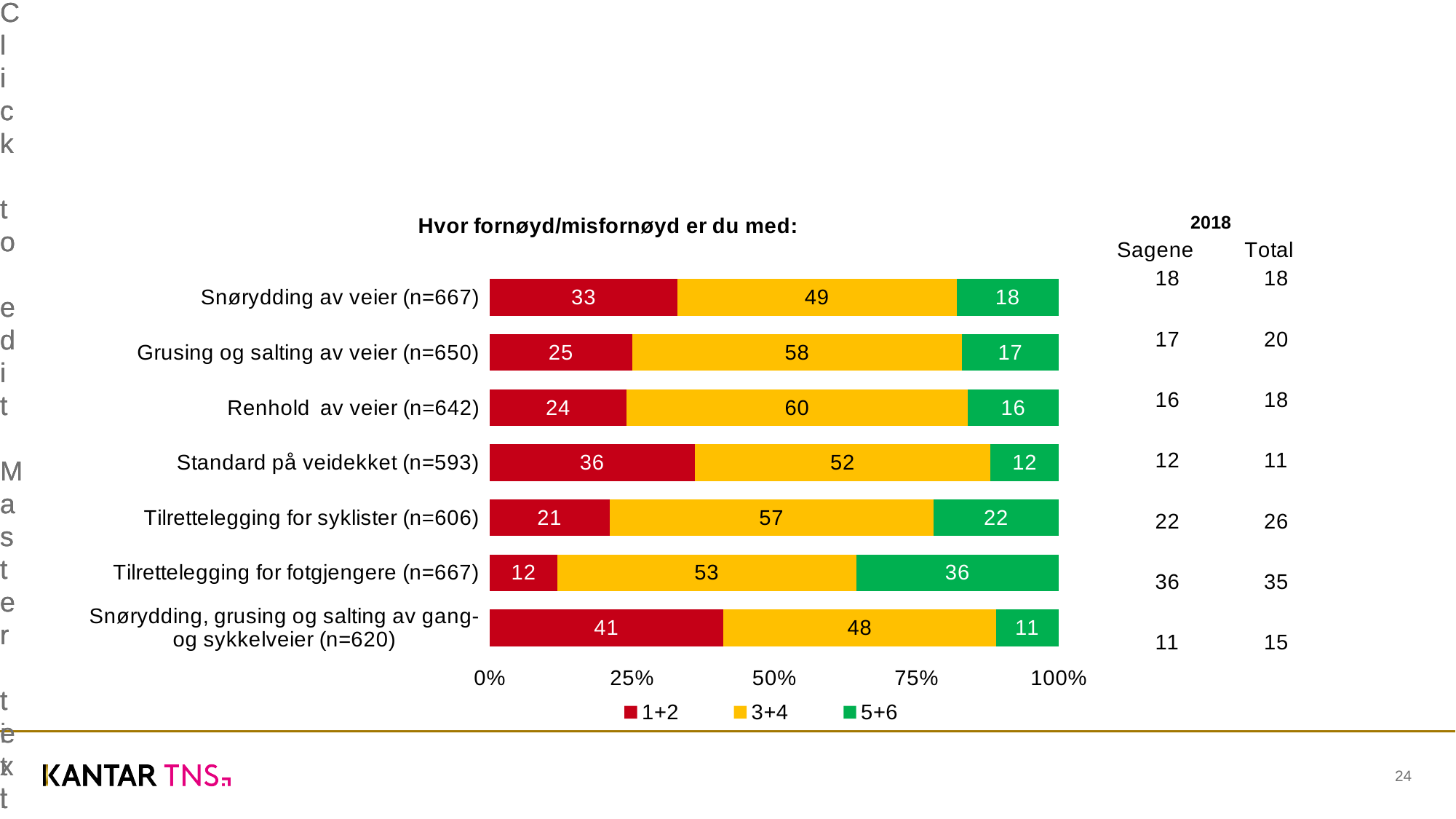
What kind of chart is shown on the slide? Stacked bar chart What is the value of the 5+6 series for Tilrettelegging for fotgjengere (n=667)? 36 Which category has the highest value in the 1+2 series? Snørydding, grusing og salting av gang- og sykkelveier (n=620) What is the total of the stacked bar for Tilrettelegging for syklister (n=606)? 100 What is the value of the 3+4 series for Renhold av veier (n=642)? 60 How many categories are shown in the chart? 7 Which category has the lowest value in the 5+6 series? Snørydding, grusing og salting av gang- og sykkelveier (n=620) How many series does the legend list? 3 What is the difference between the 3+4 values for Grusing og salting av veier (n=650) and Snørydding av veier (n=667)? 9 What is the title of the chart? Hvor fornøyd/misfornøyd er du med: What is the value of the 1+2 series for Snørydding av veier (n=667)? 33 Which is larger: the 1+2 value for Standard på veidekket (n=593) or the 1+2 value for Tilrettelegging for syklister (n=606)? Standard på veidekket (n=593)